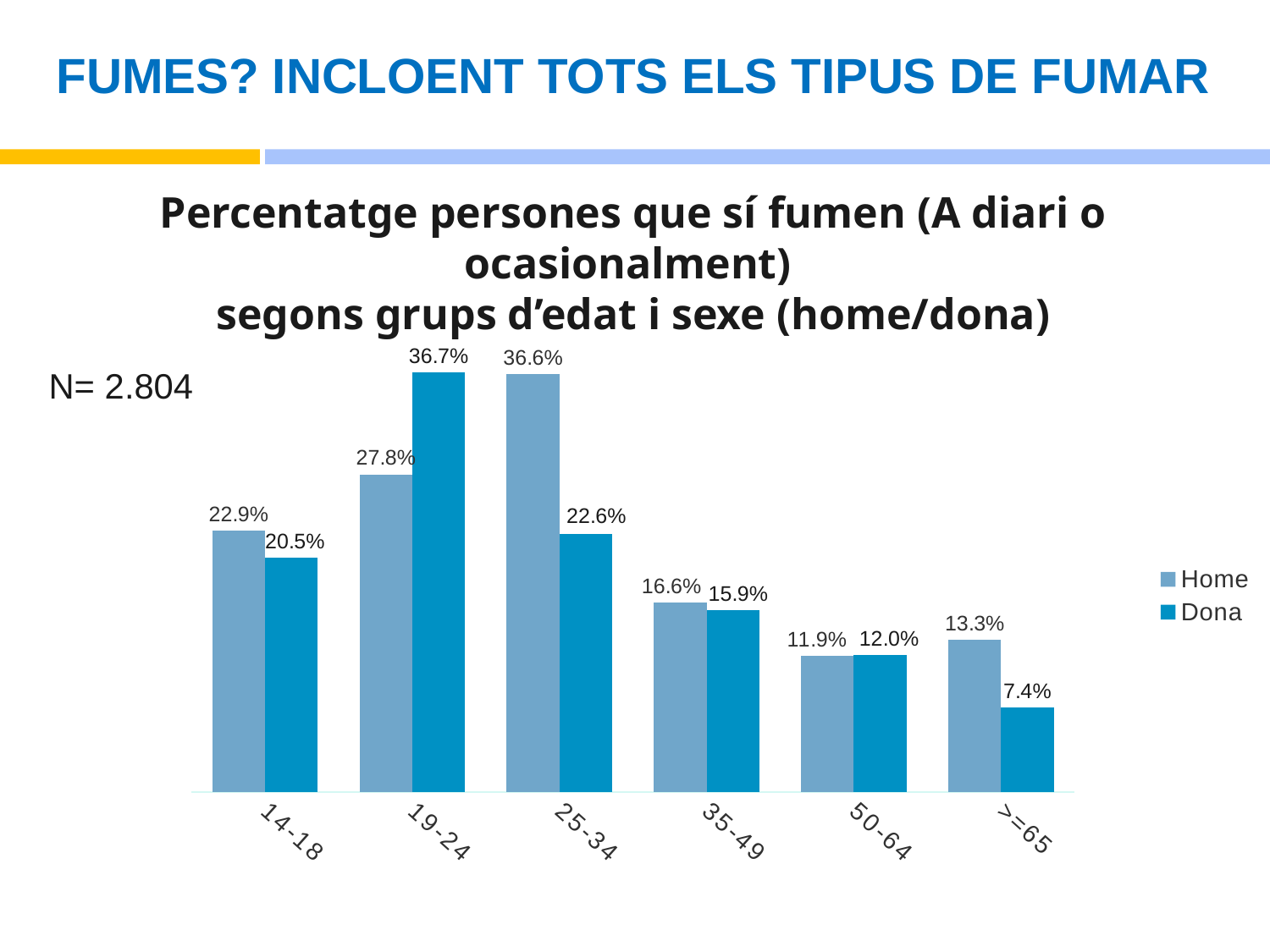
What is the value for Dona in the 25-34 age group? 22.6% Which age group has the lowest value for Home? 50-64 Do the Dona values rise or fall from the 19-24 group to the >=65 group? Fall What kind of chart is shown on the slide? Bar chart How many series does the legend list? 2 Which age group has the highest value for Dona? 19-24 What is the value for Dona in the >=65 age group? 7.4% What is the difference between Home and Dona in the 25-34 age group? 14.0% What is the value for Home in the 19-24 age group? 27.8% How many age groups are shown on the x axis? 6 What sample size (N) is stated on the slide? N= 2.804 Which is larger in the 14-18 age group, Home or Dona? Home